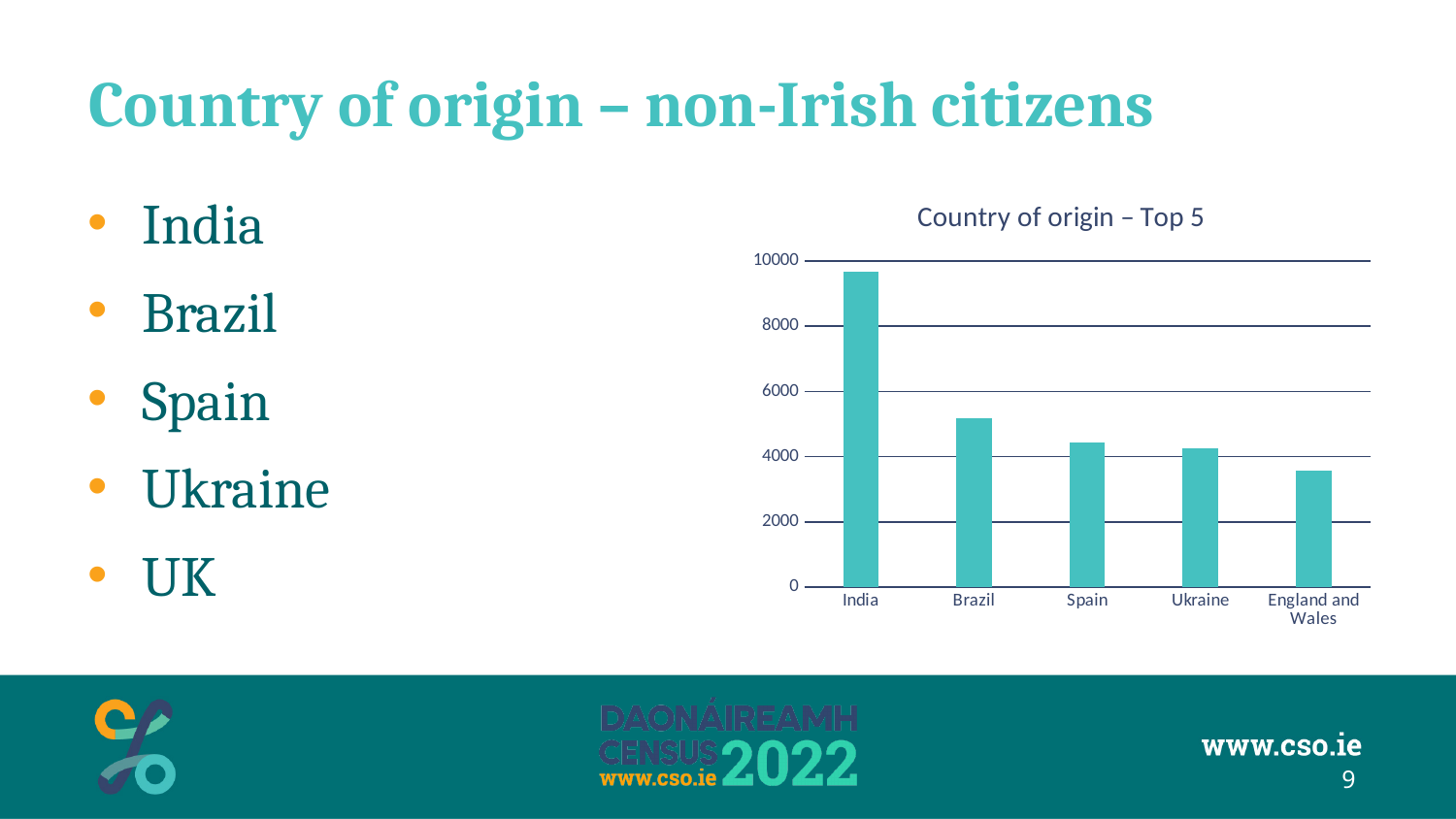
Is the value for India greater or less than 8000? greater What is the title of the chart? Country of origin – Top 5 Is the value for England and Wales greater or less than 4000? less Is the value for Brazil greater or less than 4000? greater Which country has the lowest value in the chart? England and Wales How many countries are shown in the chart? 5 Which has a larger value, Brazil or Spain? Brazil What kind of chart is shown on the slide? Bar chart Which country has the highest value in the chart? India Which has a larger value, India or Brazil? India Do the values rise or fall from left to right across the chart? fall